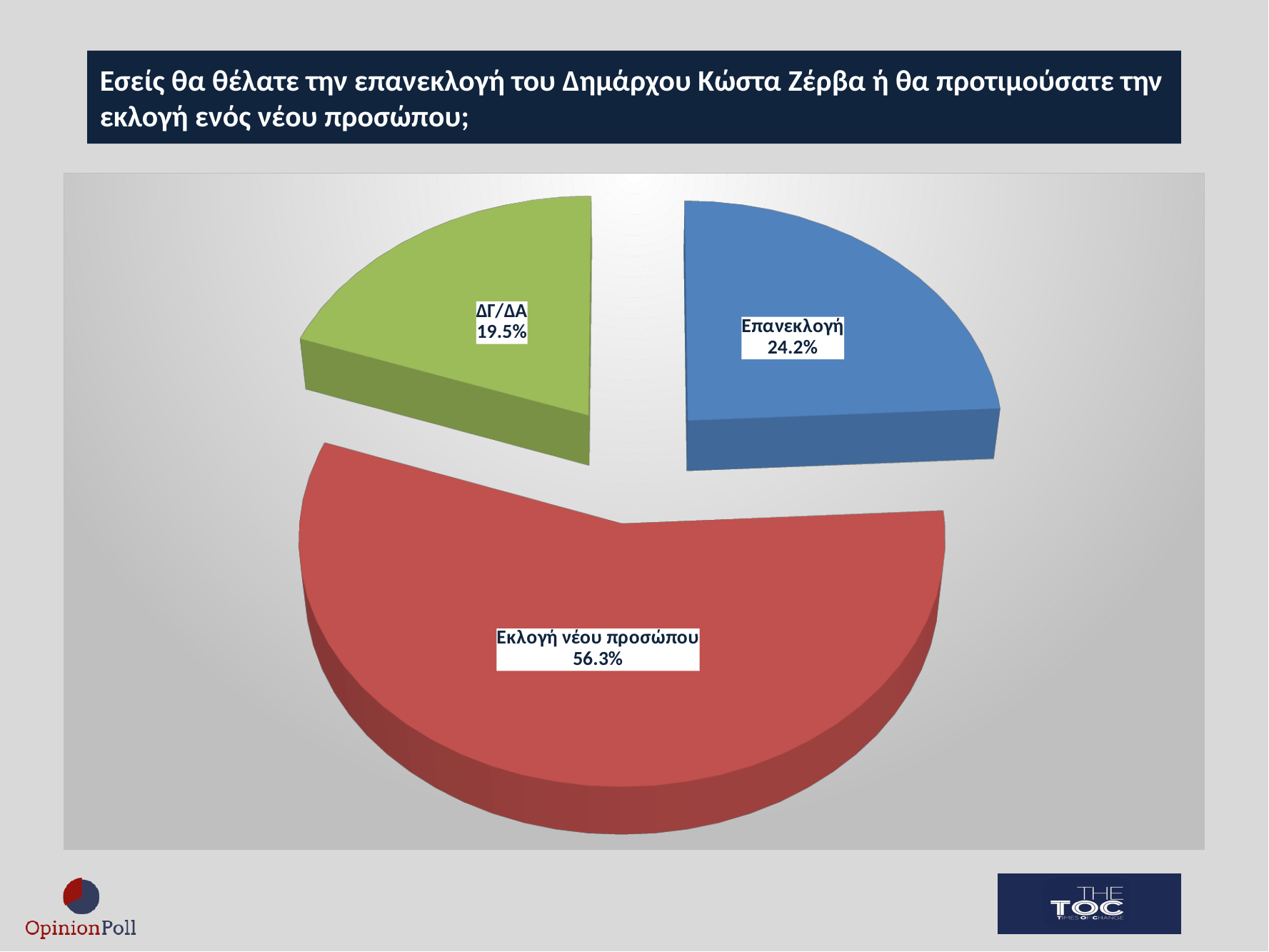
What percentage of respondents chose 'Εκλογή νέου προσώπου'? 56.3% What colour is the slice for 'Εκλογή νέου προσώπου'? Red What percentage of respondents chose 'Επανεκλογή'? 24.2% What kind of chart is shown on the slide? Pie chart What is the difference in percentage points between 'Επανεκλογή' and 'ΔΓ/ΔΑ'? 4.7 What percentage of respondents answered 'ΔΓ/ΔΑ'? 19.5% What is the difference in percentage points between 'Εκλογή νέου προσώπου' and 'Επανεκλογή'? 32.1 Which is larger: the share for 'Επανεκλογή' or the share for 'ΔΓ/ΔΑ'? Επανεκλογή Which response has the smallest share of the pie? ΔΓ/ΔΑ How many slices does the pie chart have? 3 Which response has the largest share of the pie? Εκλογή νέου προσώπου What colour is the slice for 'Επανεκλογή'? Blue